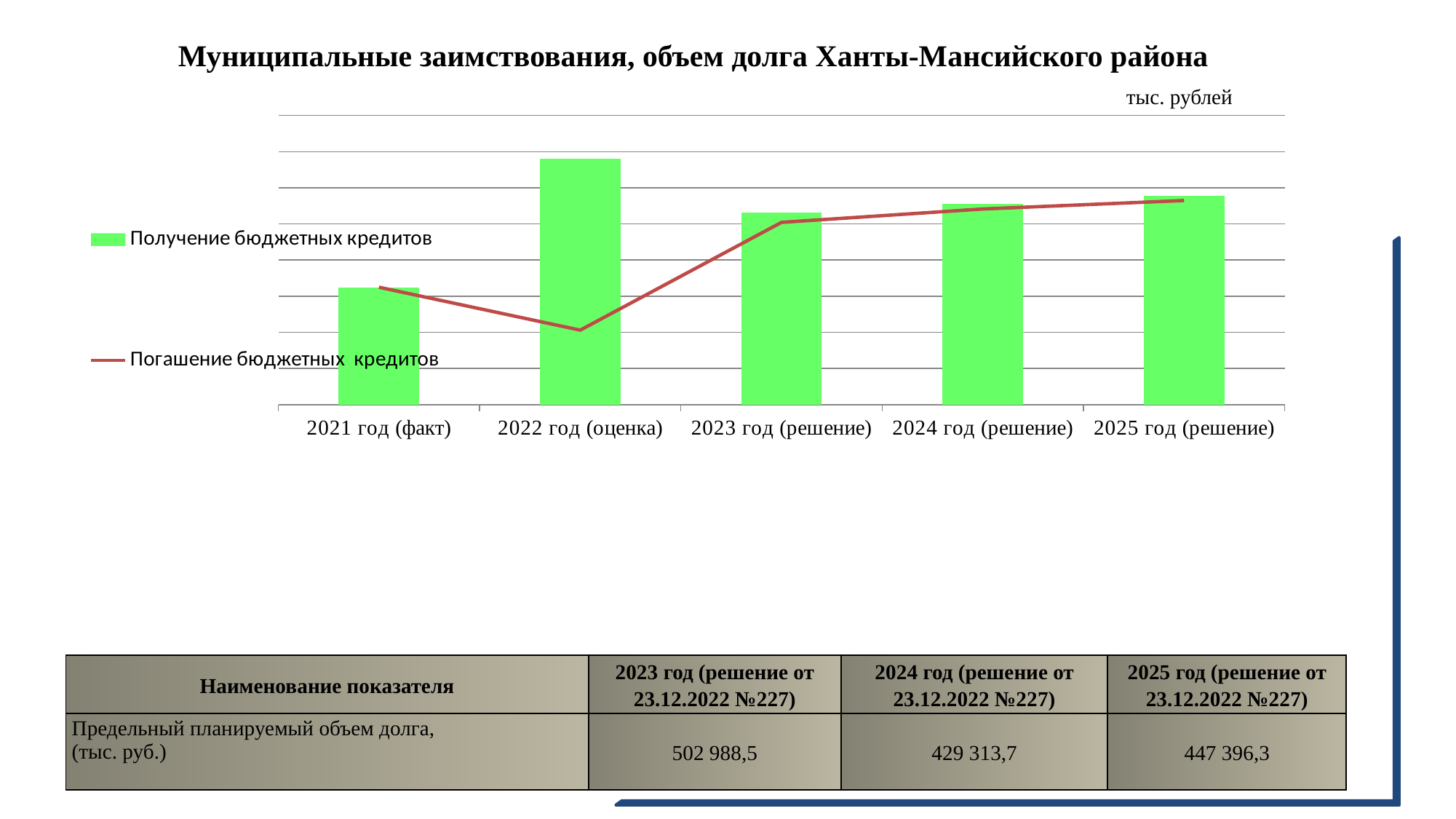
In which year is the Погашение бюджетных кредитов line at its lowest point? 2022 год (оценка) How many year categories are shown on the x axis of the chart? 5 Which year has the highest bar for Получение бюджетных кредитов? 2022 год (оценка) In which year is the Погашение бюджетных кредитов line at its highest point? 2025 год (решение) Does the Погашение бюджетных кредитов line rise or fall from 2021 год (факт) to 2022 год (оценка)? fall What is the title of the chart? Муниципальные заимствования, объем долга Ханты-Мансийского района How many series does the chart legend list? 2 Which is larger for Получение бюджетных кредитов: 2022 год (оценка) or 2023 год (решение)? 2022 год (оценка) Which year has the lowest bar for Получение бюджетных кредитов? 2021 год (факт) Does the Погашение бюджетных кредитов line rise or fall from 2022 год (оценка) to 2025 год (решение)? rise Which is larger for Погашение бюджетных кредитов: 2021 год (факт) or 2022 год (оценка)? 2021 год (факт) Which series in the chart is drawn as green bars? Получение бюджетных кредитов